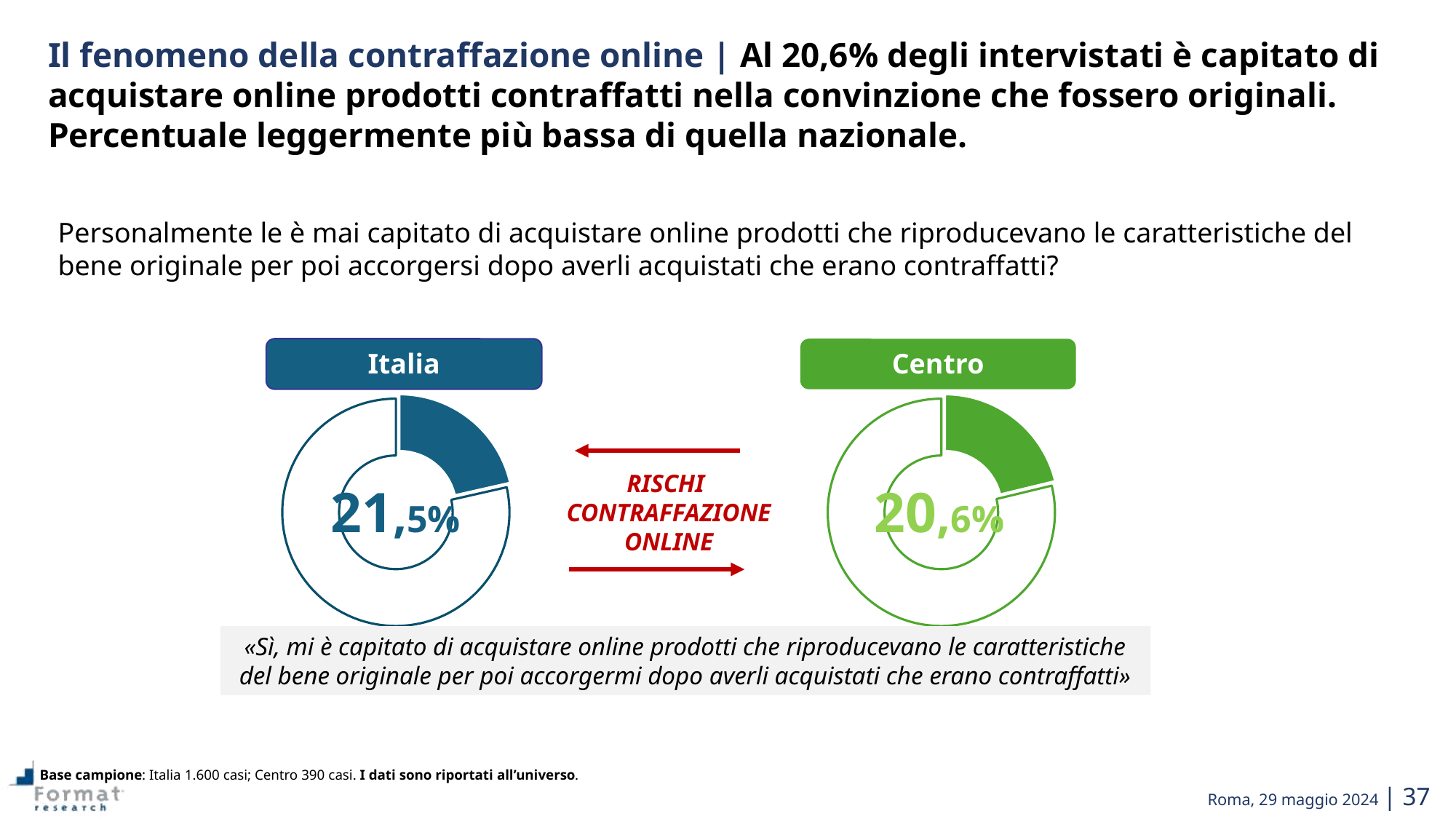
What colour is the highlighted slice in the Centro donut chart? Green Is the value shown in the Italia chart greater or less than 20%? greater What share of the Centro donut does the highlighted green slice represent? 20,6% What label appears in the box above the left donut chart? Italia How many donut charts are shown on the slide? 2 What is the difference between the Italia value and the Centro value? 0,9 percentage points Which of the two charts, Italia or Centro, shows the higher percentage? Italia What value is shown in the centre of the Italia donut chart? 21,5% Which of the two charts, Italia or Centro, shows the lower percentage? Centro What value is shown in the centre of the Centro donut chart? 20,6% What kind of chart is used to show the Italia and Centro values? Donut (pie) chart